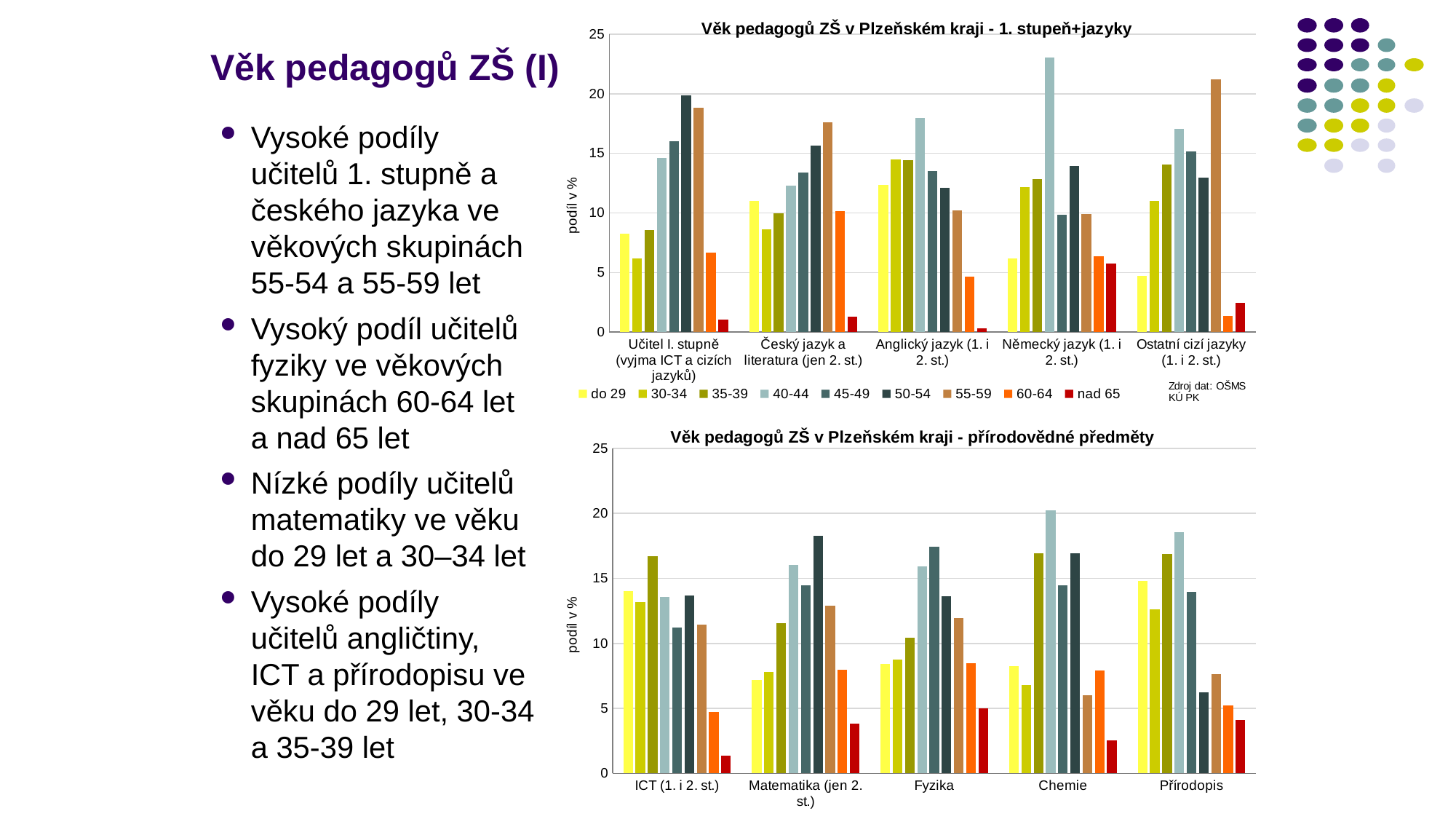
In the top chart, for 'Český jazyk a literatura (jen 2. st.)', which is larger: the 55-59 group or the 50-54 group? 55-59 In the top chart, which age group has the lowest value for 'Anglický jazyk (1. i 2. st.)'? nad 65 What kind of chart is the top chart, 'Věk pedagogů ZŠ v Plzeňském kraji - 1. stupeň+jazyky'? bar chart In the top chart, which age group has the highest value for 'Německý jazyk (1. i 2. st.)'? 40-44 In the top chart, is the value for the 40-44 age group in 'Německý jazyk (1. i 2. st.)' greater or less than 20? greater What is the label of the y axis on the bottom chart? podíl v % In the bottom chart, is the value for the 'nad 65' age group in 'ICT (1. i 2. st.)' greater or less than 5? less How many categories are shown on the x axis of the bottom chart, 'Věk pedagogů ZŠ v Plzeňském kraji - přírodovědné předměty'? 5 In the bottom chart, for 'Přírodopis', which is larger: the 'do 29' group or the 30-34 group? do 29 In the bottom chart, is the value for the 50-54 age group in 'Matematika (jen 2. st.)' greater or less than 15? greater How many series does the legend of the top chart list? 9